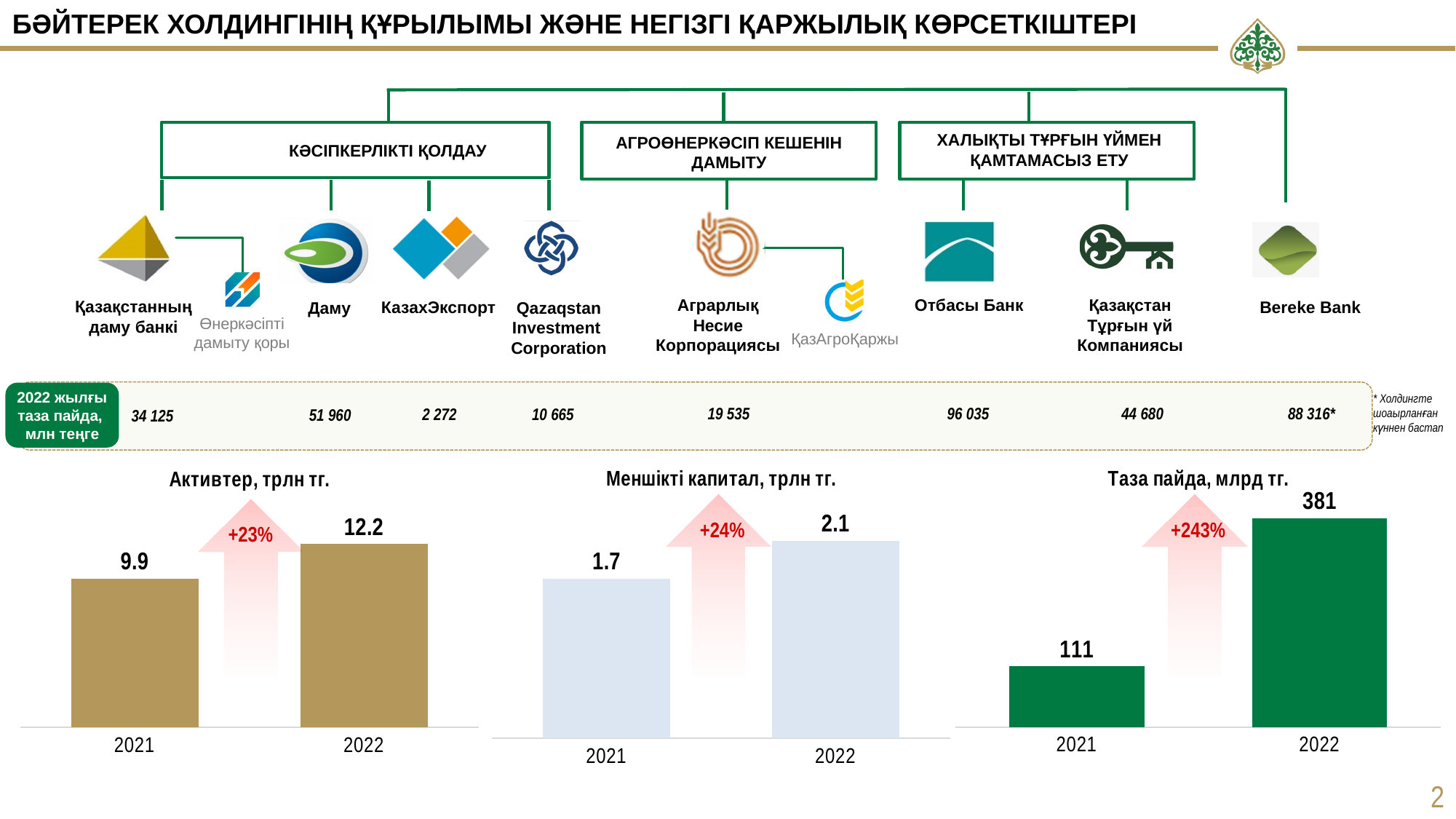
In the chart titled "Активтер, трлн тг.", which year has the higher value? 2022 In the chart titled "Меншікті капитал, трлн тг.", what is the difference between the 2022 and 2021 values? 0.4 In the chart titled "Меншікті капитал, трлн тг.", what is the value for 2021? 1.7 In the chart titled "Таза пайда, млрд тг.", what is the value for 2021? 111 In the chart titled "Активтер, трлн тг.", what is the value for 2022? 12.2 In the chart titled "Активтер, трлн тг.", what is the value for 2021? 9.9 In the chart titled "Таза пайда, млрд тг.", what is the difference between the 2022 and 2021 values? 270 What kind of chart is the chart titled "Меншікті капитал, трлн тг."? bar chart In the chart titled "Таза пайда, млрд тг.", what is the value for 2022? 381 In the chart titled "Активтер, трлн тг.", do the values rise or fall from 2021 to 2022? rise In the chart titled "Таза пайда, млрд тг.", which year has the lowest value? 2021 What percentage change is shown on the arrow in the chart titled "Таза пайда, млрд тг."? +243%